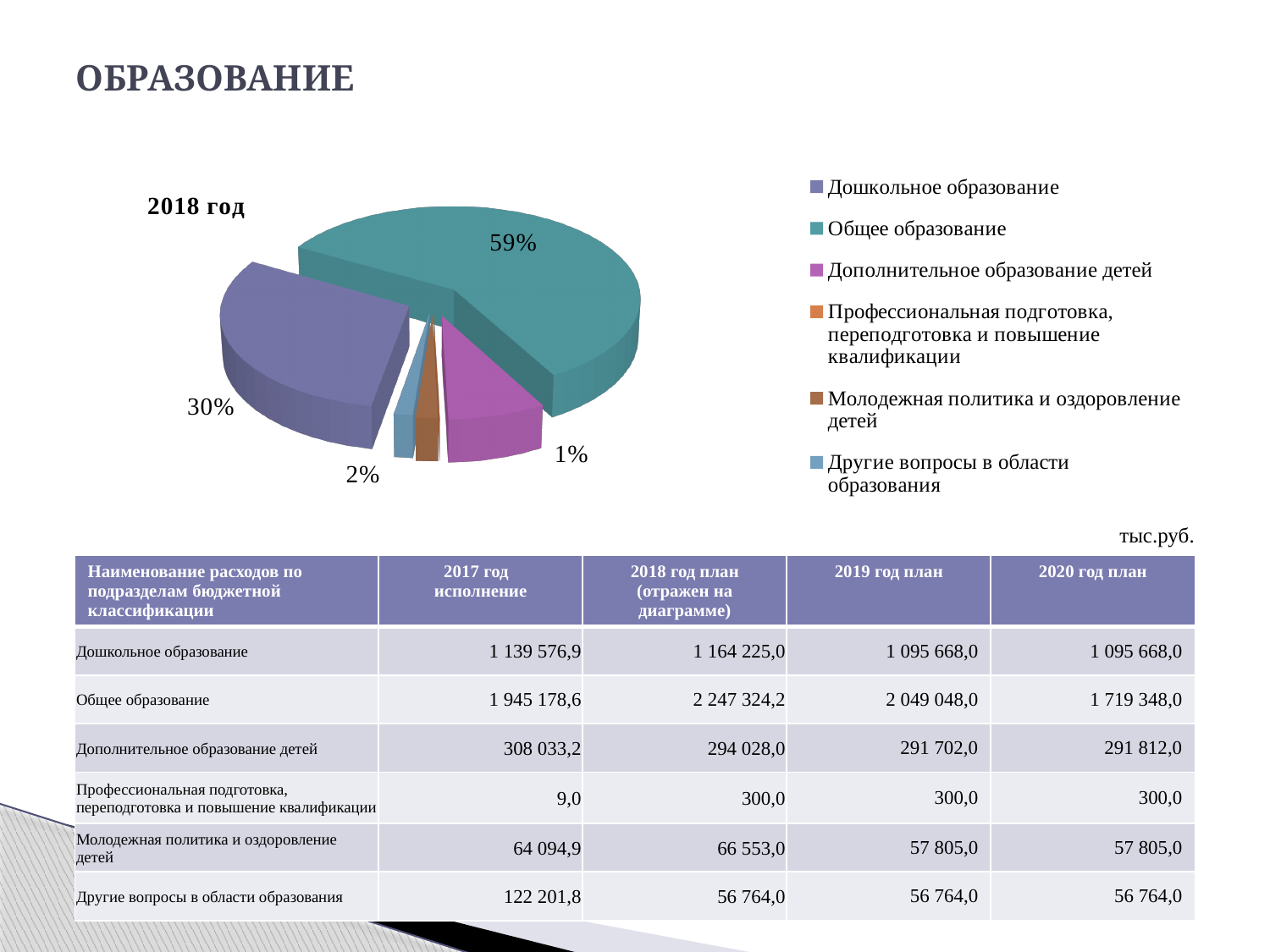
Which category has the largest slice in the pie chart? Общее образование Which category is shown in teal (green-blue) in the pie chart? Общее образование What share of the pie does Дошкольное образование have? 30% By how many percentage points does the Общее образование slice exceed the Дошкольное образование slice? 29 Which category is shown in purple in the pie chart? Дошкольное образование Which slice is larger in the pie chart: Общее образование or Дошкольное образование? Общее образование What share of the pie does Общее образование have? 59% How many categories does the legend of the pie chart list? 6 Is the share of Дошкольное образование in the pie chart greater or less than 50%? less Is the share of Общее образование in the pie chart greater or less than 50%? greater What kind of chart is shown on the slide? pie chart What is the title of the pie chart? 2018 год